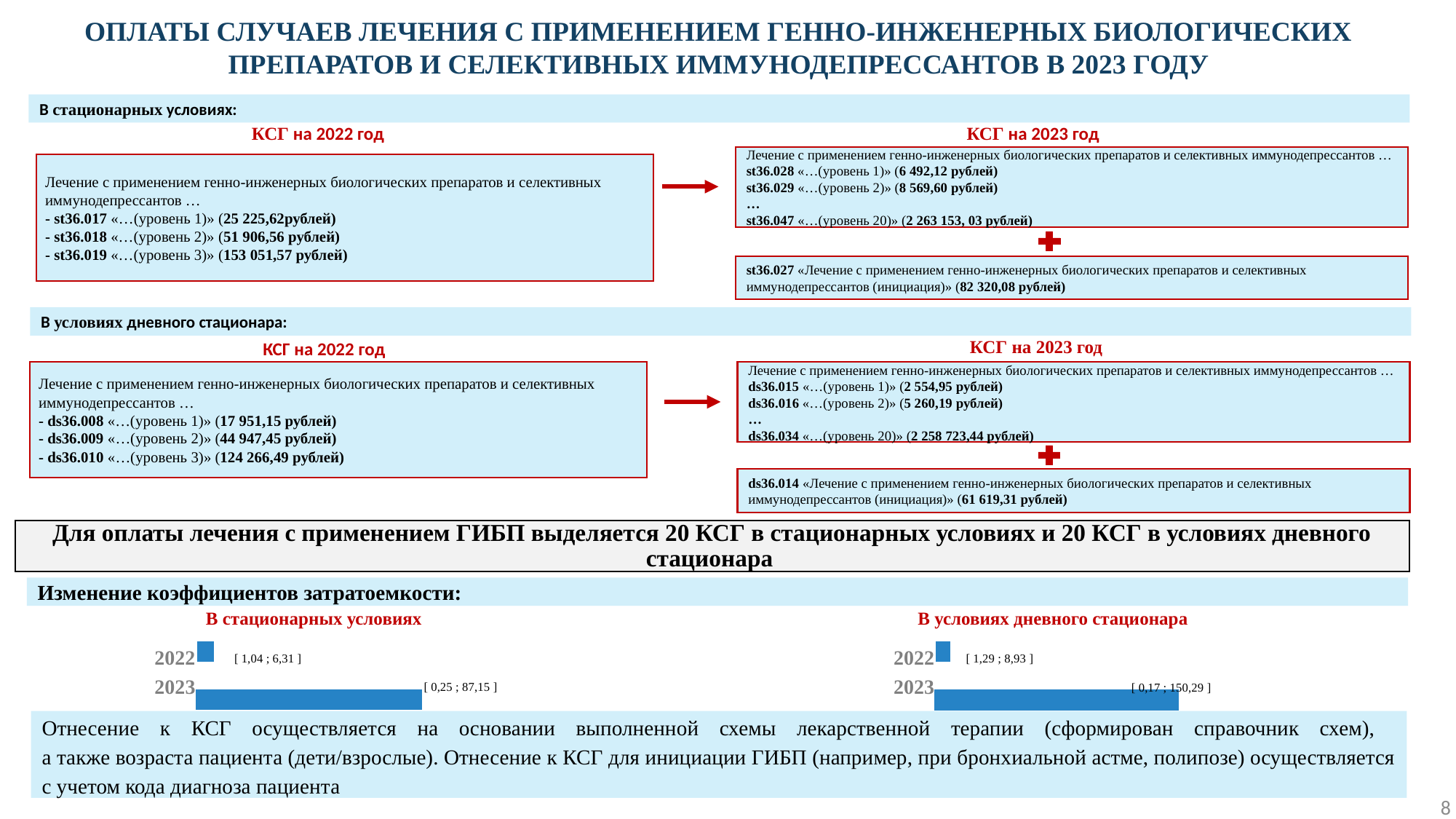
In the chart titled 'В стационарных условиях', which year has the longer bar, 2022 or 2023? 2023 In the chart titled 'В стационарных условиях', what is the upper bound of the range shown for 2022? 6,31 What is the title of the left chart in the 'Изменение коэффициентов затратоемкости' section? В стационарных условиях In the chart titled 'В условиях дневного стационара', what range label is shown for 2022? [ 1,29 ; 8,93 ] In the chart titled 'В условиях дневного стационара', what range label is shown for 2023? [ 0,17 ; 150,29 ] In the chart titled 'В стационарных условиях', what range label is shown for 2023? [ 0,25 ; 87,15 ] What kind of chart is used under 'В условиях дневного стационара'? Bar chart In the chart titled 'В стационарных условиях', what range label is shown for 2022? [ 1,04 ; 6,31 ] In the chart titled 'В условиях дневного стационара', which year has the shorter bar? 2022 In the chart titled 'В условиях дневного стационара', what is the upper bound of the range shown for 2023? 150,29 How many years (categories) are plotted in the chart titled 'В стационарных условиях'? 2 In the chart titled 'В условиях дневного стационара', does the bar length increase or decrease from 2022 to 2023? Increase